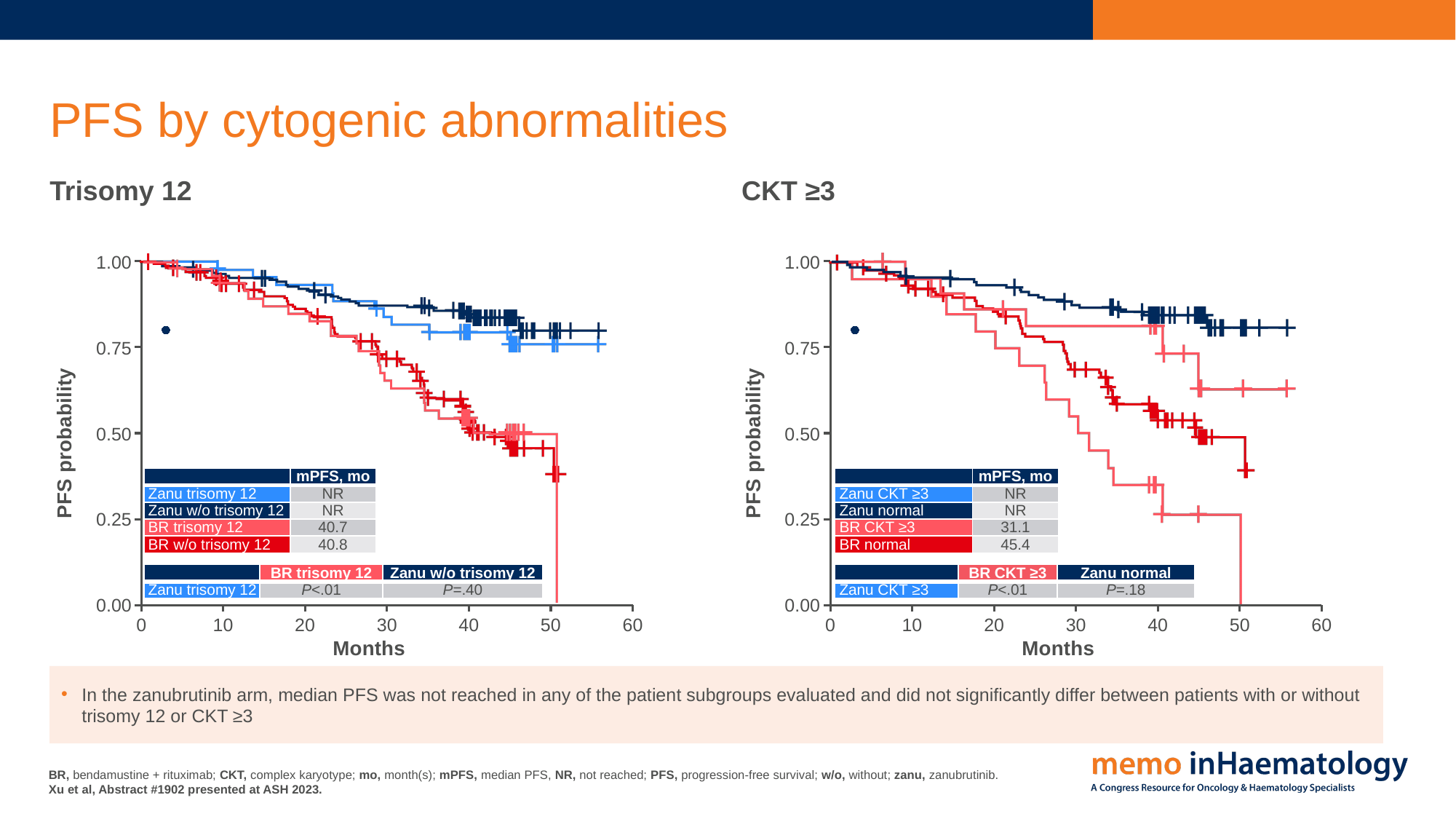
How many patient groups (curves) are plotted in the Trisomy 12 chart? 4 In the Trisomy 12 chart, what is the median PFS for Zanu trisomy 12? NR In the CKT ≥3 chart, what is the median PFS in months for BR CKT ≥3? 31.1 What kind of chart is the CKT ≥3 chart? Line chart (Kaplan-Meier curve) In the CKT ≥3 chart, what is the difference in median PFS (months) between BR normal and BR CKT ≥3? 14.3 In the CKT ≥3 chart, which has the longer median PFS, BR CKT ≥3 or BR normal? BR normal In the Trisomy 12 chart, what is the median PFS in months for BR trisomy 12? 40.7 In the Trisomy 12 chart, what is the P value for Zanu trisomy 12 versus BR trisomy 12? P<.01 In the CKT ≥3 chart, what is the median PFS in months for BR normal? 45.4 In the Trisomy 12 chart, what is the median PFS in months for BR w/o trisomy 12? 40.8 In the CKT ≥3 chart, is the PFS probability for BR CKT ≥3 at 40 months greater or less than 0.50? less In the CKT ≥3 chart, what is the P value for Zanu CKT ≥3 versus Zanu normal? P=.18